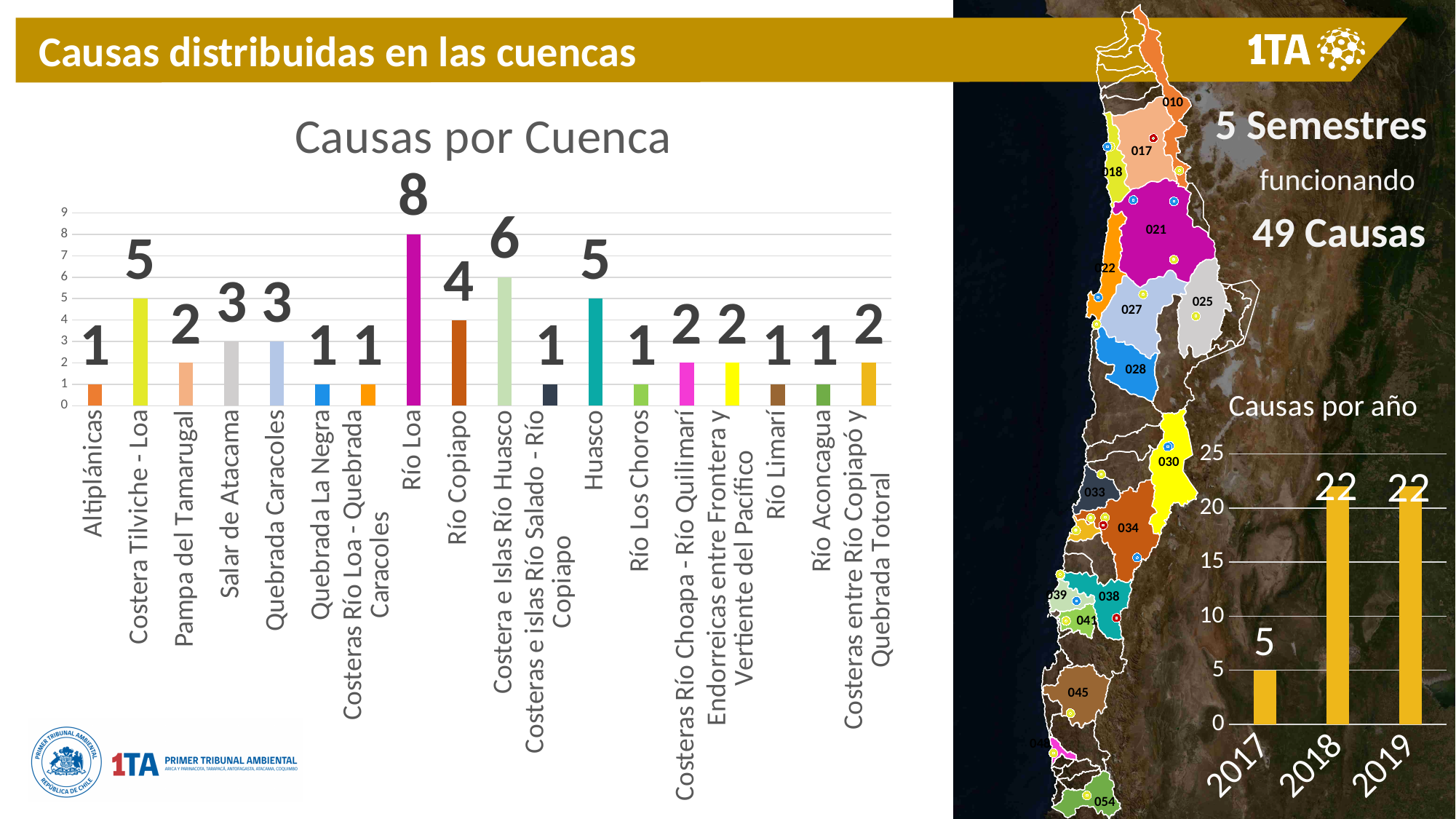
In the 'Causas por año' chart, what is the value for 2018? 22 In the 'Causas por año' chart, what is the value for 2017? 5 In the 'Causas por Cuenca' chart, which cuenca has the highest value? Río Loa What kind of chart is 'Causas por Cuenca'? Bar chart In the 'Causas por Cuenca' chart, what is the value for Río Loa? 8 In the 'Causas por Cuenca' chart, what is the value for Costera e Islas Río Huasco? 6 In the 'Causas por Cuenca' chart, what is the difference between Río Loa and Huasco? 3 In the 'Causas por año' chart, what is the difference between 2018 and 2017? 17 How many years are shown in the 'Causas por año' chart? 3 In the 'Causas por Cuenca' chart, what is the value for Río Copiapo? 4 How many cuencas are shown in the 'Causas por Cuenca' chart? 18 In the 'Causas por Cuenca' chart, which is larger: Costera Tilviche - Loa or Salar de Atacama? Costera Tilviche - Loa